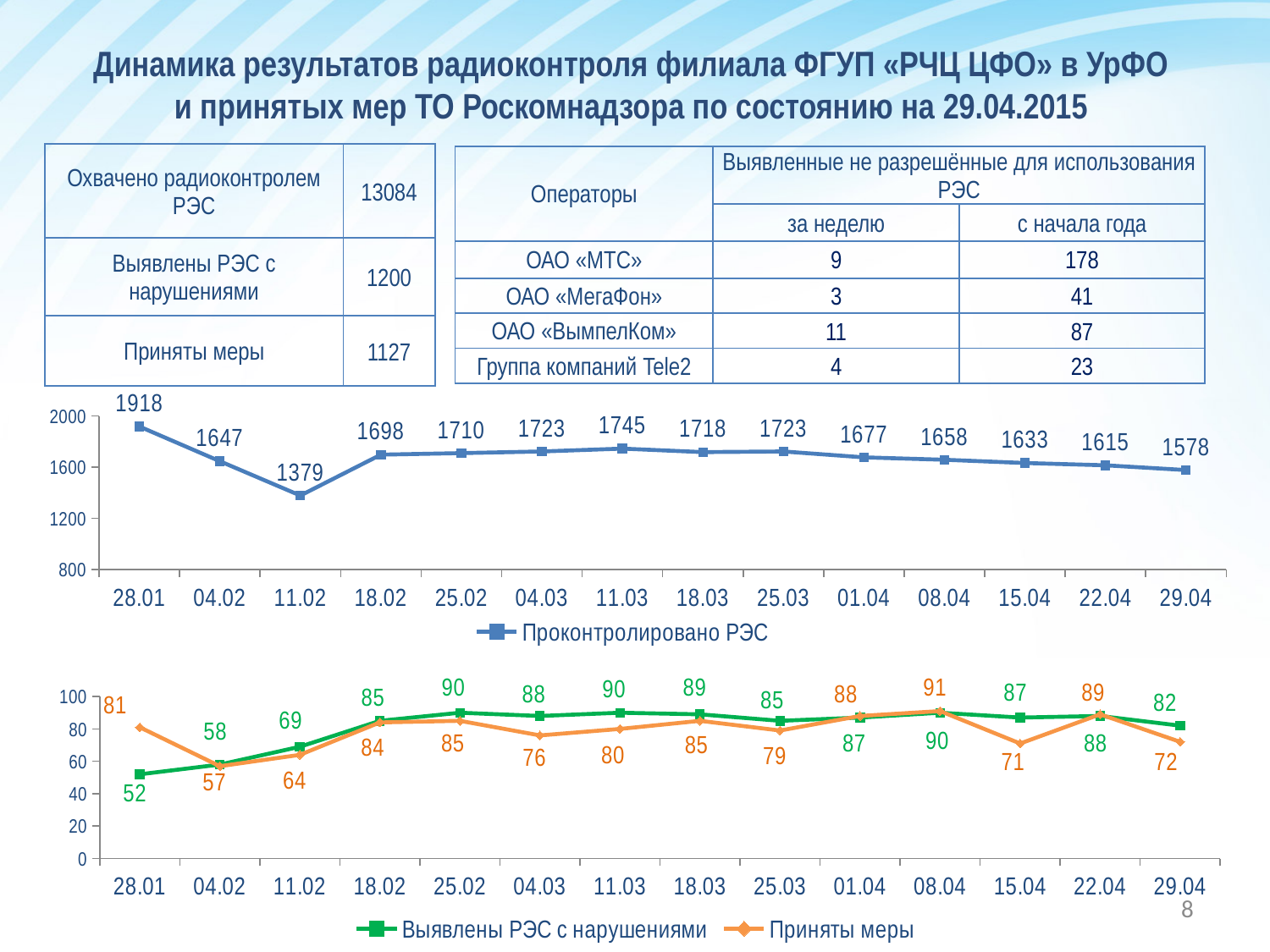
How many data points are plotted in the top chart (Проконтролировано РЭС)? 14 What type of chart is the bottom chart? line chart In the bottom chart, which is larger on 28.01: Выявлены РЭС с нарушениями or Приняты меры? Приняты меры In the bottom chart, what is the difference between Выявлены РЭС с нарушениями and Приняты меры on 15.04? 16 In the top chart (Проконтролировано РЭС), which date has the highest value? 28.01 In the top chart (Проконтролировано РЭС), what is the value for 28.01? 1918 In the top chart (Проконтролировано РЭС), which date has the lowest value? 11.02 In the top chart (Проконтролировано РЭС), what is the difference between the values for 28.01 and 29.04? 340 In the top chart (Проконтролировано РЭС), do the values rise or fall from 11.03 to 29.04? fall How many series does the legend of the bottom chart list? 2 In the bottom chart, what is the value of Приняты меры for 04.03? 76 In the bottom chart, what is the value of Выявлены РЭС с нарушениями for 08.04? 90